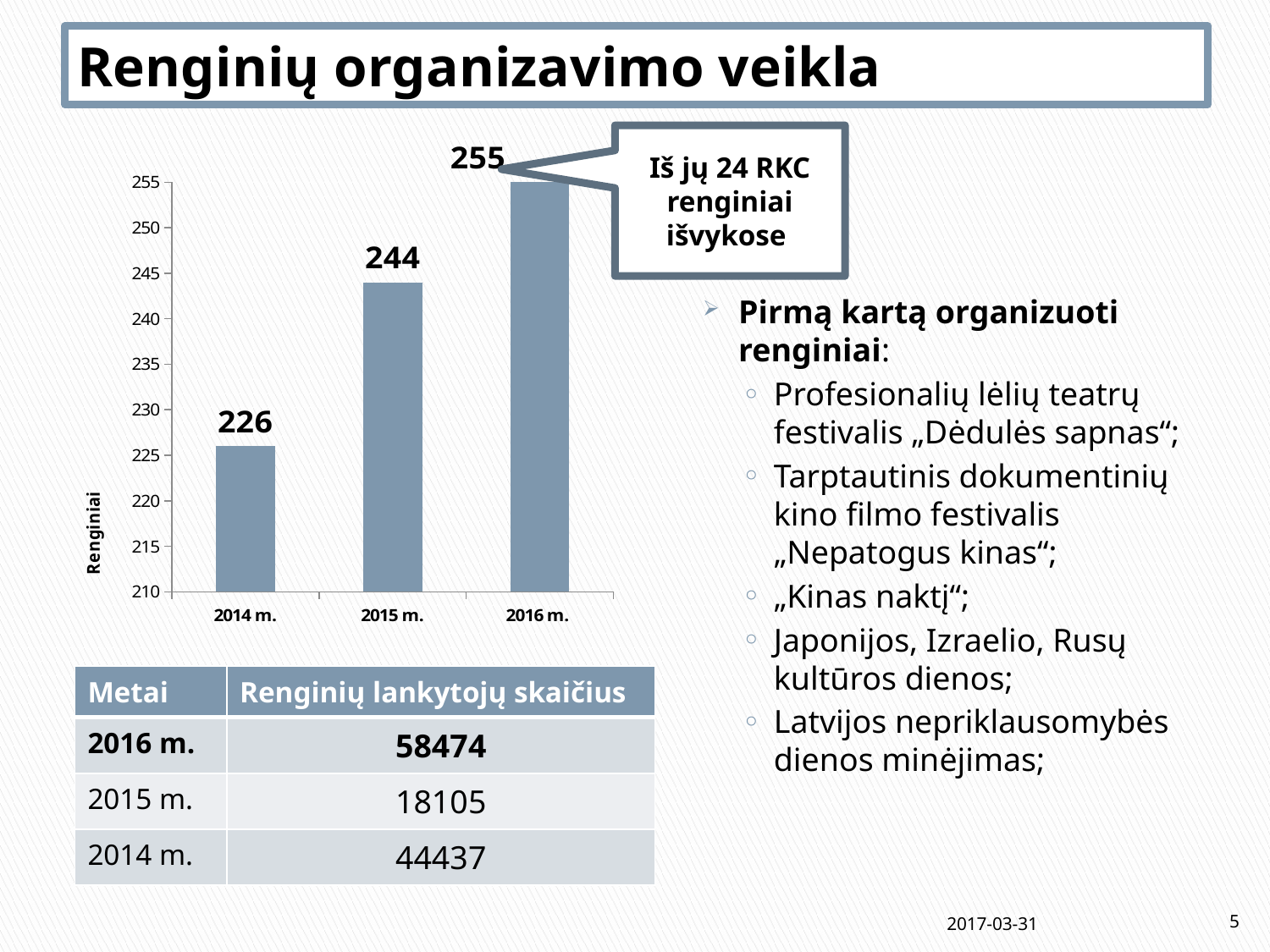
Which is larger, the value for 2015 m. or the value for 2016 m.? 2016 m. What is the difference between the values for 2015 m. and 2014 m.? 18 Which year has the lowest value in the chart? 2014 m. What is the difference between the values for 2016 m. and 2014 m.? 29 What kind of chart is shown on the slide? bar chart What is the value for 2014 m. in the chart? 226 Which year has the highest value in the chart? 2016 m. Is the value for 2015 m. greater or less than 240? greater Do the values rise or fall from 2014 m. to 2016 m.? rise What is the value for 2016 m. in the chart? 255 How many categories are shown on the x axis of the chart? 3 What is the value for 2015 m. in the chart? 244